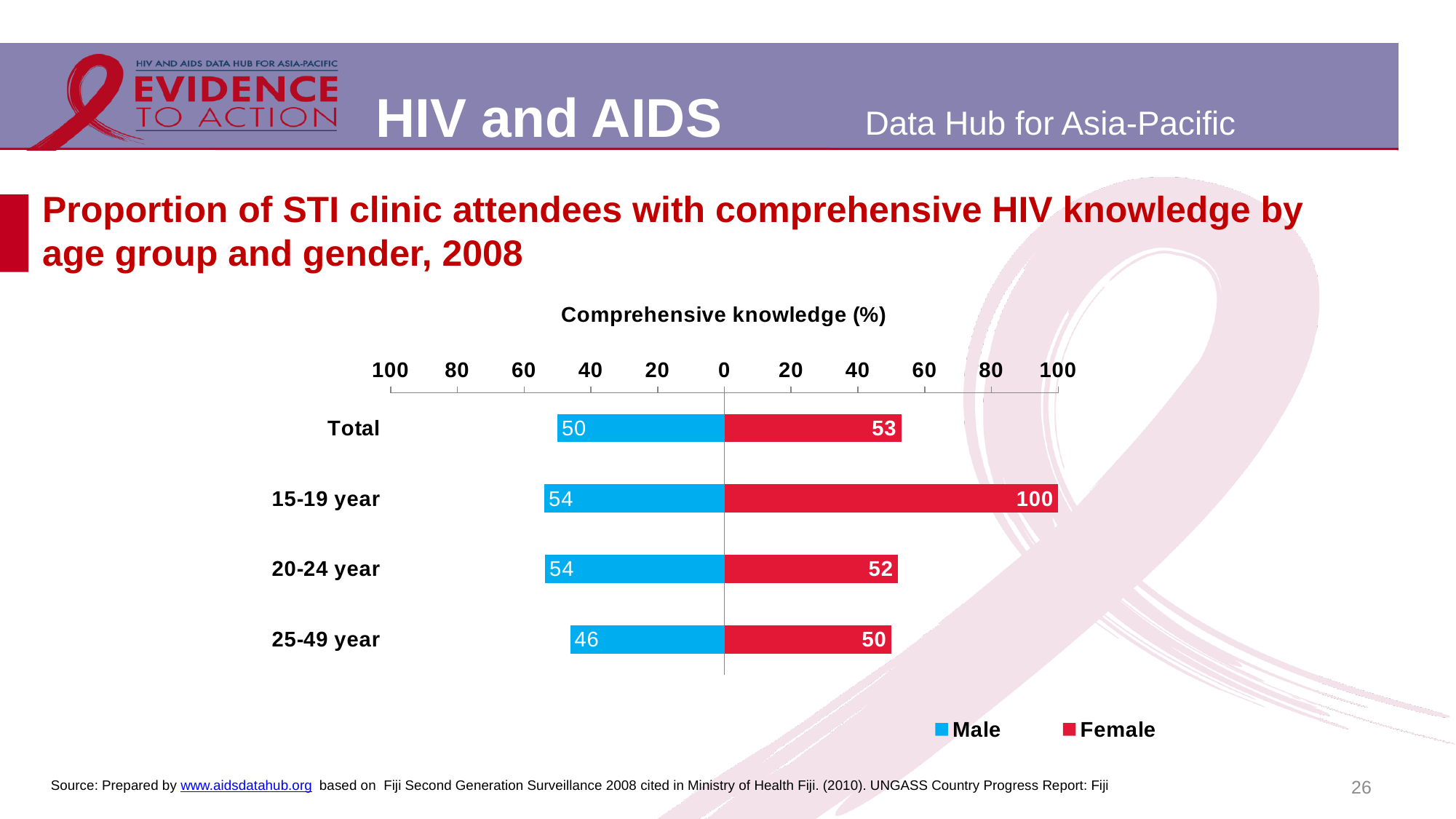
Which category has the lowest Male value? 25-49 year What is the Female value for Total? 53 What is the Male value for the 25-49 year age group? 46 What is the Female value for the 15-19 year age group? 100 What colour represents the Female series? Red For the 20-24 year age group, which is larger, the Male value or the Female value? Male What is the difference between the Female and Male values for the 15-19 year age group? 46 How many age-group categories (including Total) are shown on the chart? 4 What is the Male value for the 20-24 year age group? 54 Which category has the highest Female value? 15-19 year How many series does the legend list? 2 What kind of chart is shown on the slide? Bar chart